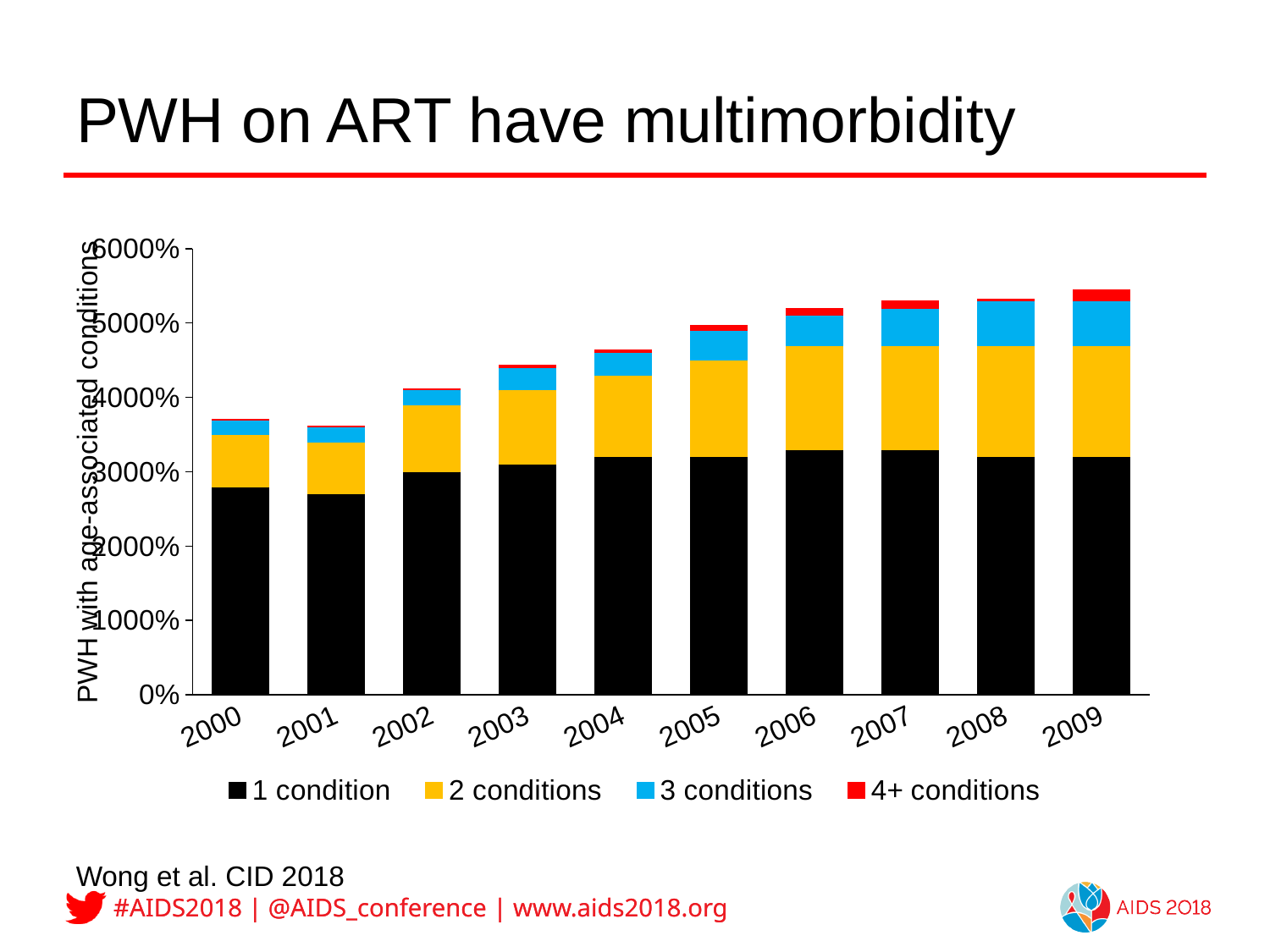
Is the total height of the 2000 bar greater or less than 4000%? less Is the '1 condition' segment for 2000 greater or less than 3000%? less What colour represents '4+ conditions' in the chart's legend? Red Is the total height of the 2006 bar greater or less than 5000%? greater Which bar is taller overall, 2003 or 2008? 2008 Which year has the tallest stacked bar in the chart? 2009 What kind of chart is shown on the slide? Stacked bar chart How many series does the chart's legend list? 4 Do the total bar heights generally rise or fall from 2000 to 2009? rise How many years are shown along the x axis of the chart? 10